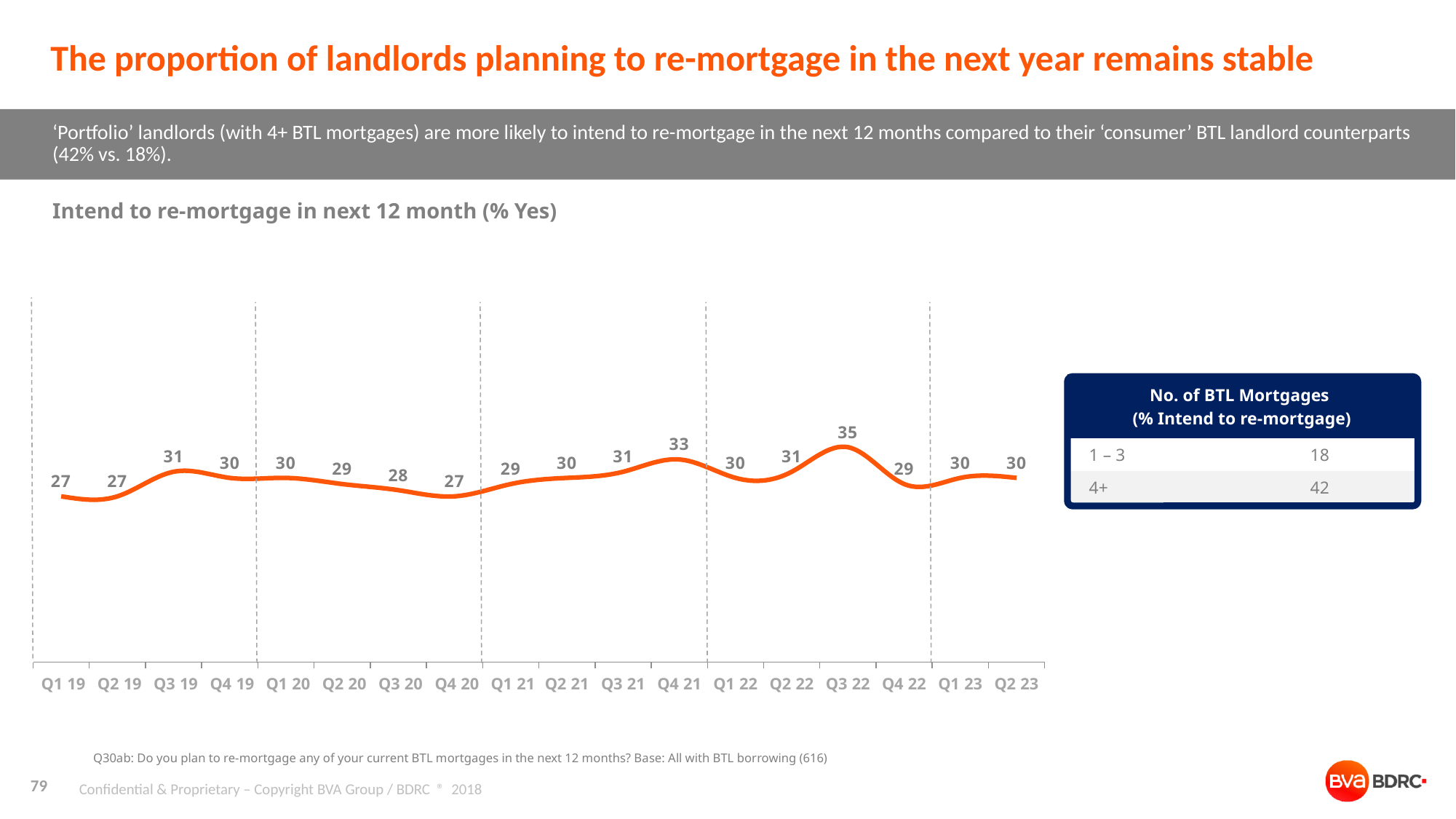
What type of chart is shown on the slide? line chart What is the value for Q4 21? 33 What is the difference between the values for Q3 22 and Q4 22? 6 What is the title of the chart? Intend to re-mortgage in next 12 month (% Yes) In the table on the right, what is the % intend to re-mortgage for landlords with 4+ BTL mortgages? 42 Which is larger, the value for Q4 21 or the value for Q1 22? Q4 21 How many quarters are plotted on the x axis? 18 What is the value for Q3 22? 35 Which quarter has the highest value? Q3 22 What is the value for Q2 23? 30 What is the value for Q1 19? 27 What is the lowest value plotted on the chart? 27